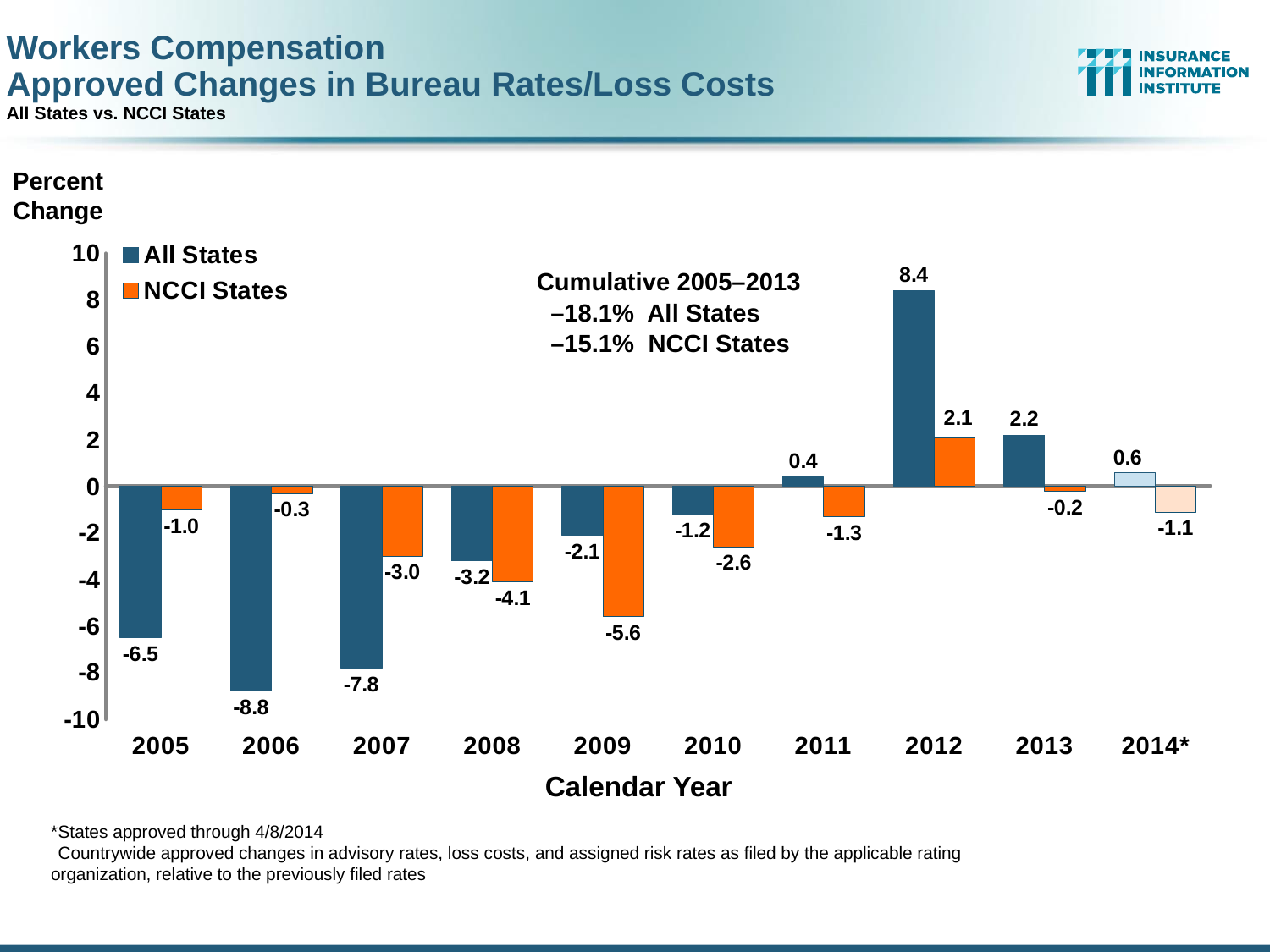
What is the All States value for 2012? 8.4 What cumulative 2005–2013 change is shown for NCCI States? –15.1% What is the All States value for 2006? -8.8 What is the NCCI States value for 2014*? -1.1 How many calendar years are shown on the x axis? 10 In which year is the NCCI States value lowest? 2009 In which year is the All States value highest? 2012 How many series does the legend list? 2 In 2008, which series has the larger value, All States or NCCI States? All States What is the NCCI States value for 2009? -5.6 What kind of chart is shown on the slide? Bar chart What is the difference between the All States and NCCI States values in 2012? 6.3